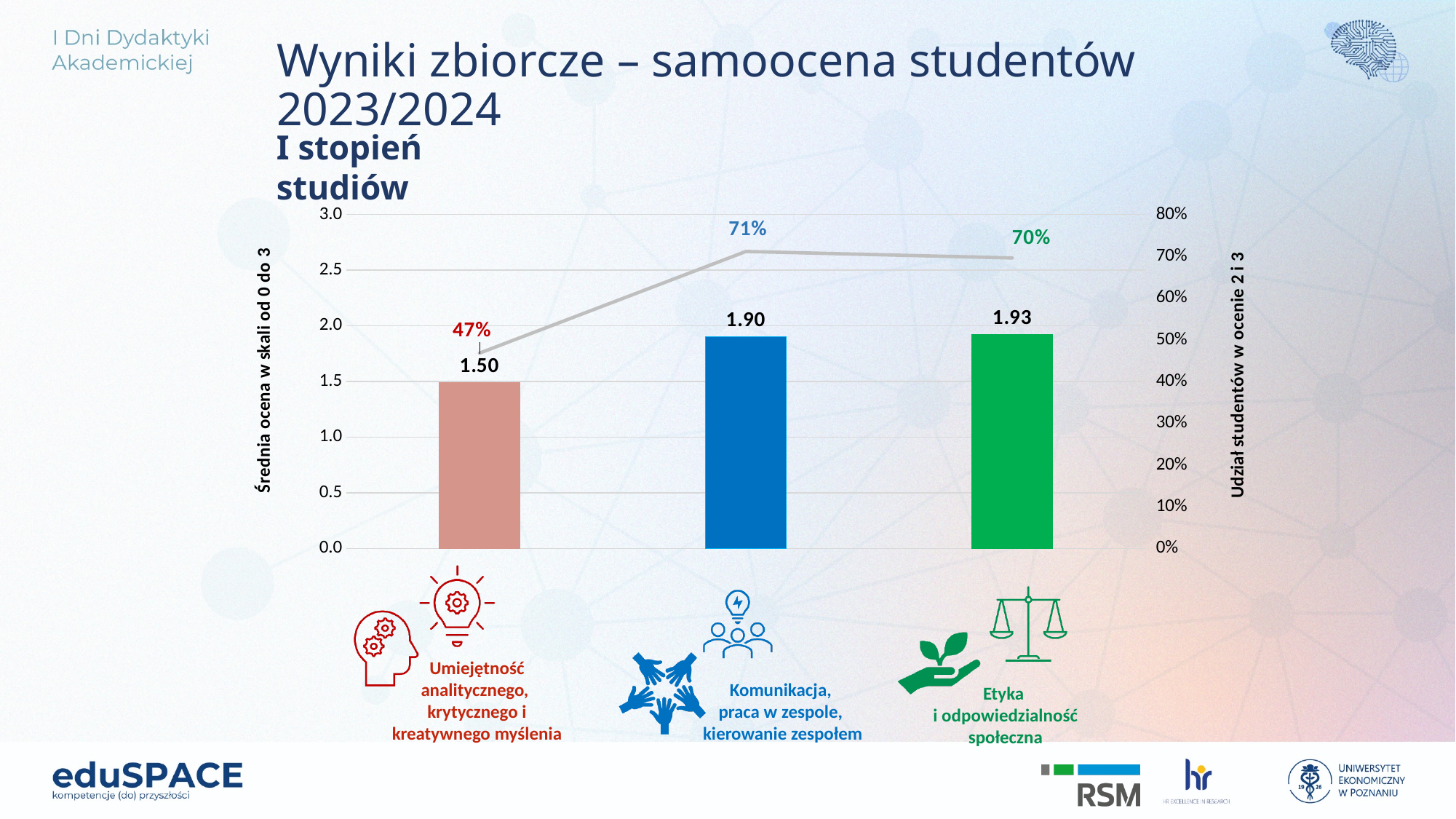
Which has a higher average score: Komunikacja, praca w zespole, kierowanie zespołem or Umiejętność analitycznego, krytycznego i kreatywnego myślenia? Komunikacja, praca w zespole, kierowanie zespołem What is the difference in student share between Komunikacja, praca w zespole, kierowanie zespołem and Umiejętność analitycznego, krytycznego i kreatywnego myślenia? 24% What is the difference between the average scores for Etyka i odpowiedzialność społeczna and Umiejętność analitycznego, krytycznego i kreatywnego myślenia? 0.43 What is the average score (Średnia ocena) for Etyka i odpowiedzialność społeczna? 1.93 What share of students (Udział studentów w ocenie 2 i 3) is shown for Umiejętność analitycznego, krytycznego i kreatywnego myślenia? 47% Which category has the highest share of students in the line series (Udział studentów w ocenie 2 i 3)? Komunikacja, praca w zespole, kierowanie zespołem What is the average score (Średnia ocena) for Umiejętność analitycznego, krytycznego i kreatywnego myślenia? 1.50 What is the label of the left vertical axis? Średnia ocena w skali od 0 do 3 What share of students (Udział studentów w ocenie 2 i 3) is shown for Komunikacja, praca w zespole, kierowanie zespołem? 71% How many categories are shown on the chart? 3 Which category has the lowest average score? Umiejętność analitycznego, krytycznego i kreatywnego myślenia What is the average score (Średnia ocena) for Komunikacja, praca w zespole, kierowanie zespołem? 1.90